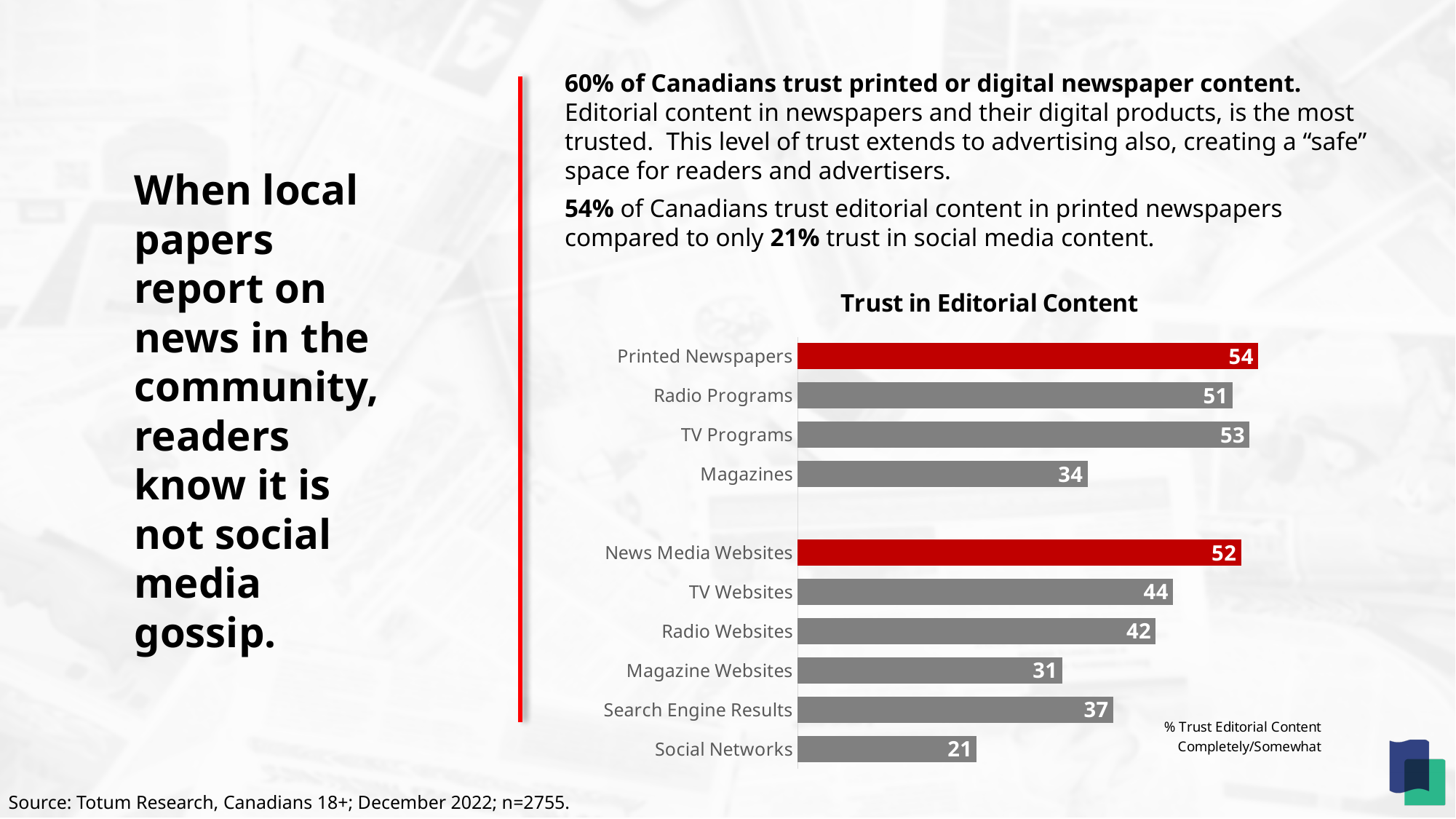
Which is larger, the value for Magazines or the value for Search Engine Results? Search Engine Results Which category has the lowest value in the Trust in Editorial Content chart? Social Networks What is the value for Printed Newspapers in the Trust in Editorial Content chart? 54 How many categories are shown in the Trust in Editorial Content chart? 10 What is the difference between the values for News Media Websites and TV Websites? 8 What kind of chart is the Trust in Editorial Content chart? Bar chart What is the difference between the values for Printed Newspapers and Social Networks? 33 What is the title of the chart on the slide? Trust in Editorial Content What is the value for Search Engine Results? 37 Which category has the highest value in the Trust in Editorial Content chart? Printed Newspapers What is the value for Social Networks in the Trust in Editorial Content chart? 21 What is the value for Magazine Websites? 31